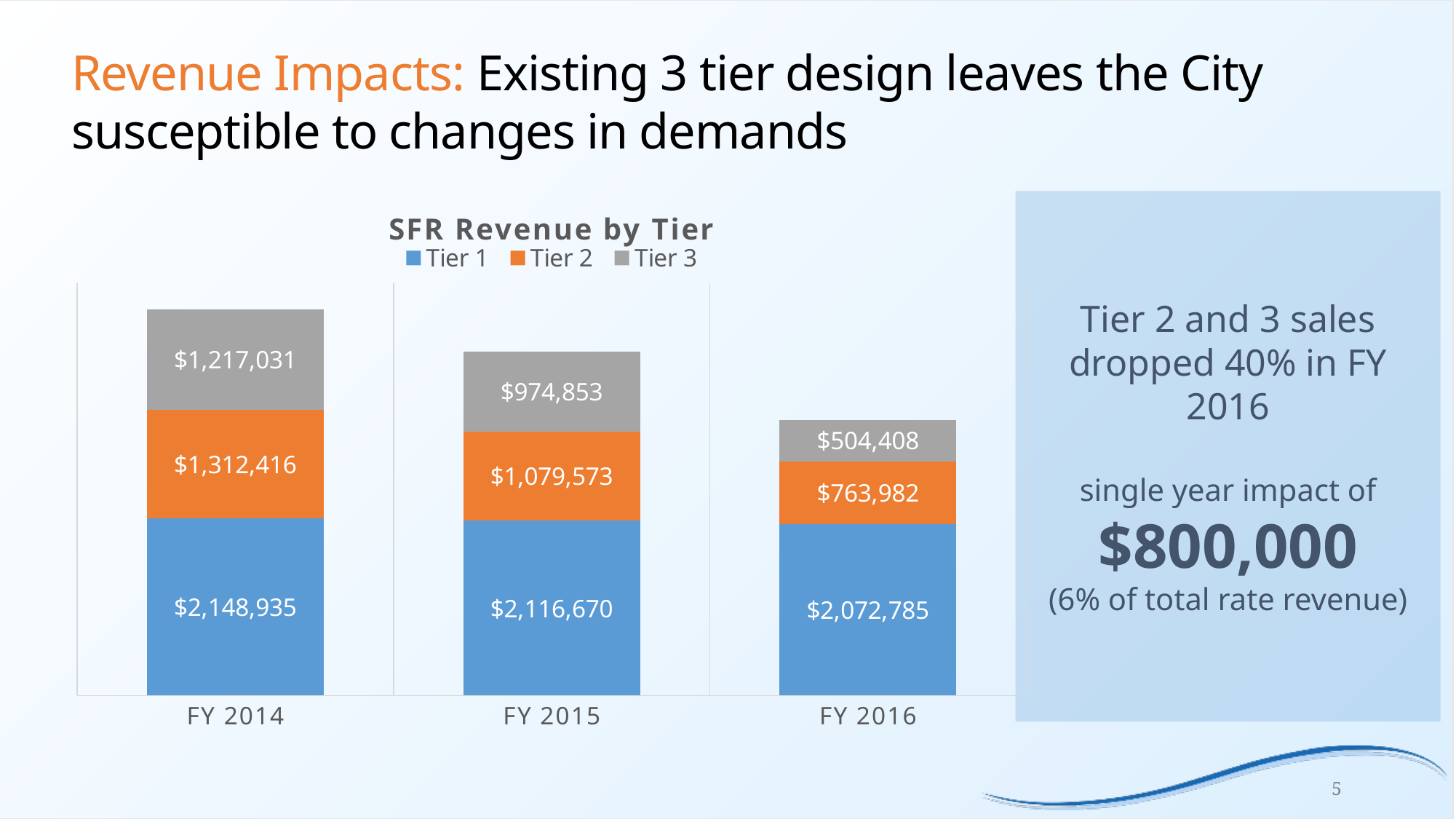
What is the difference between Tier 2 revenue in FY 2015 and FY 2016? $315,591 What is the total SFR revenue across all tiers for FY 2014? $4,678,382 How much did Tier 3 revenue fall from FY 2014 to FY 2016? $712,623 Which fiscal year has the lowest Tier 3 revenue? FY 2016 What is the Tier 3 revenue for FY 2016? $504,408 What is the Tier 1 revenue for FY 2014 in the SFR Revenue by Tier chart? $2,148,935 How many series does the legend of the SFR Revenue by Tier chart list? 3 Which fiscal year has the highest Tier 2 revenue? FY 2014 What is the total SFR revenue across all tiers for FY 2016? $3,341,175 Is Tier 2 revenue in FY 2014 larger or smaller than Tier 3 revenue in FY 2014? larger What is the Tier 2 revenue for FY 2015? $1,079,573 What kind of chart is SFR Revenue by Tier? stacked bar chart